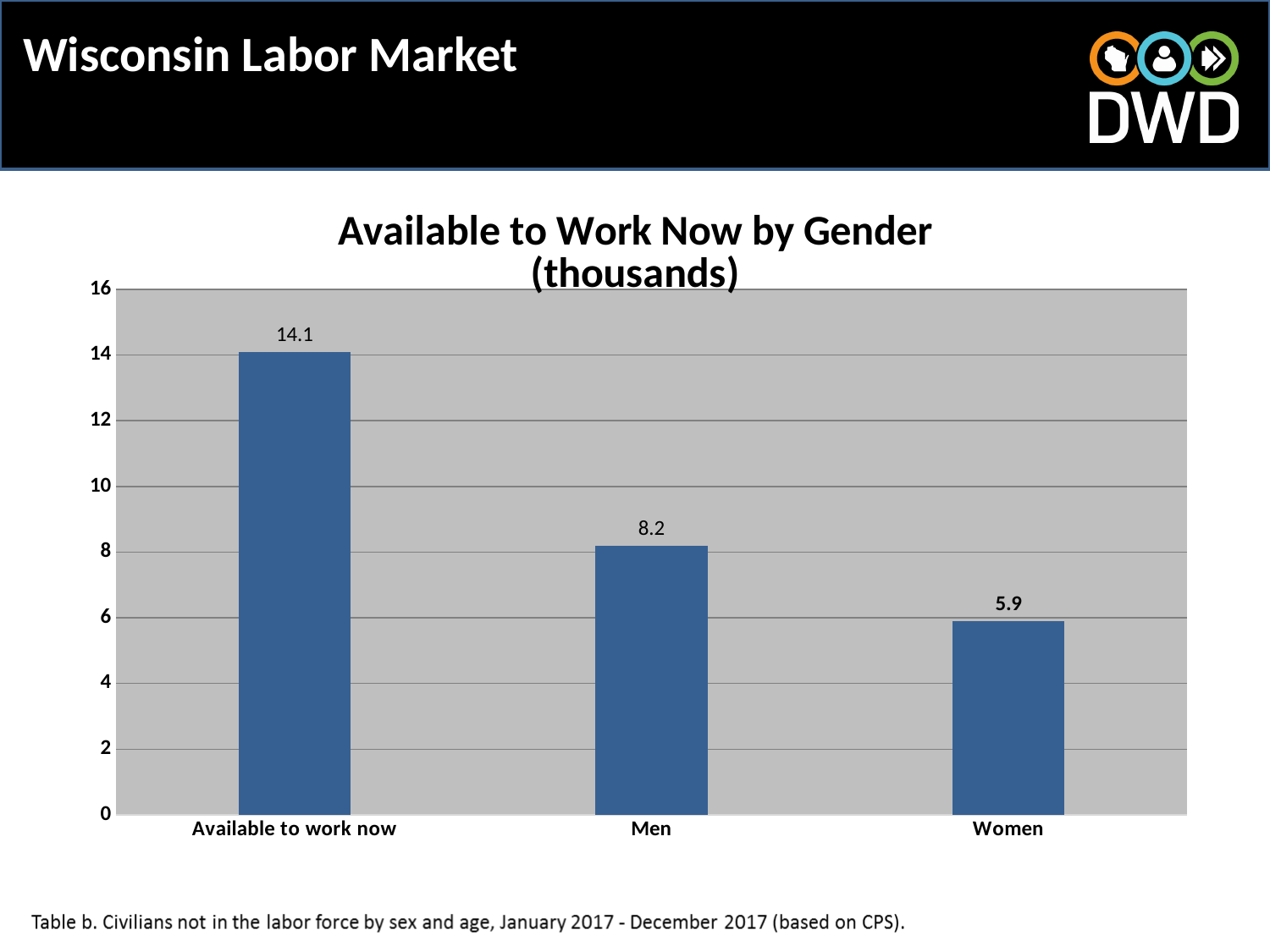
How many categories are shown on the x axis? 3 What is the difference between the values for Men and Women? 2.3 Is the value for Women greater or less than 6? less What is the value for Women? 5.9 What is the value for Men? 8.2 What is the title of the chart? Available to Work Now by Gender (thousands) What is the difference between the values for Available to work now and Men? 5.9 What is the value for Available to work now? 14.1 Which category has the highest value? Available to work now Which is larger, the value for Men or the value for Women? Men Which category has the lowest value? Women What kind of chart is shown on the slide? bar chart